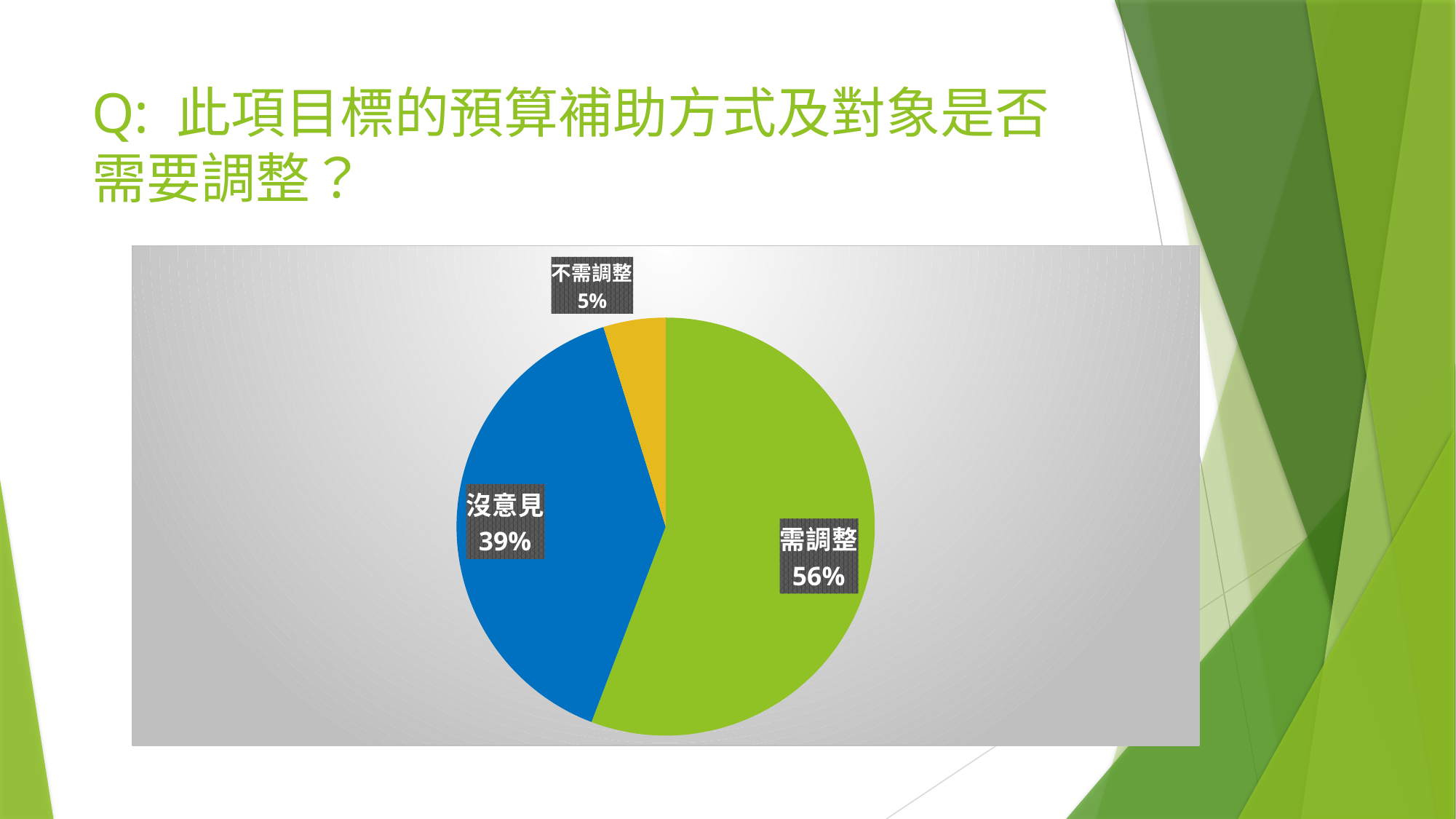
What colour is the 需調整 slice? green What is the difference in percentage points between 需調整 and 沒意見? 17% What is the difference in percentage points between 沒意見 and 不需調整? 34% How many slices does the pie chart have? 3 What share of the pie does 沒意見 have? 39% Which category has the smallest slice of the pie? 不需調整 Which is larger, the share for 沒意見 or the share for 不需調整? 沒意見 What kind of chart is shown on the slide? pie chart Which category has the largest slice of the pie? 需調整 What share of the pie does 需調整 have? 56% What share of the pie does 不需調整 have? 5% What colour is the 沒意見 slice? blue